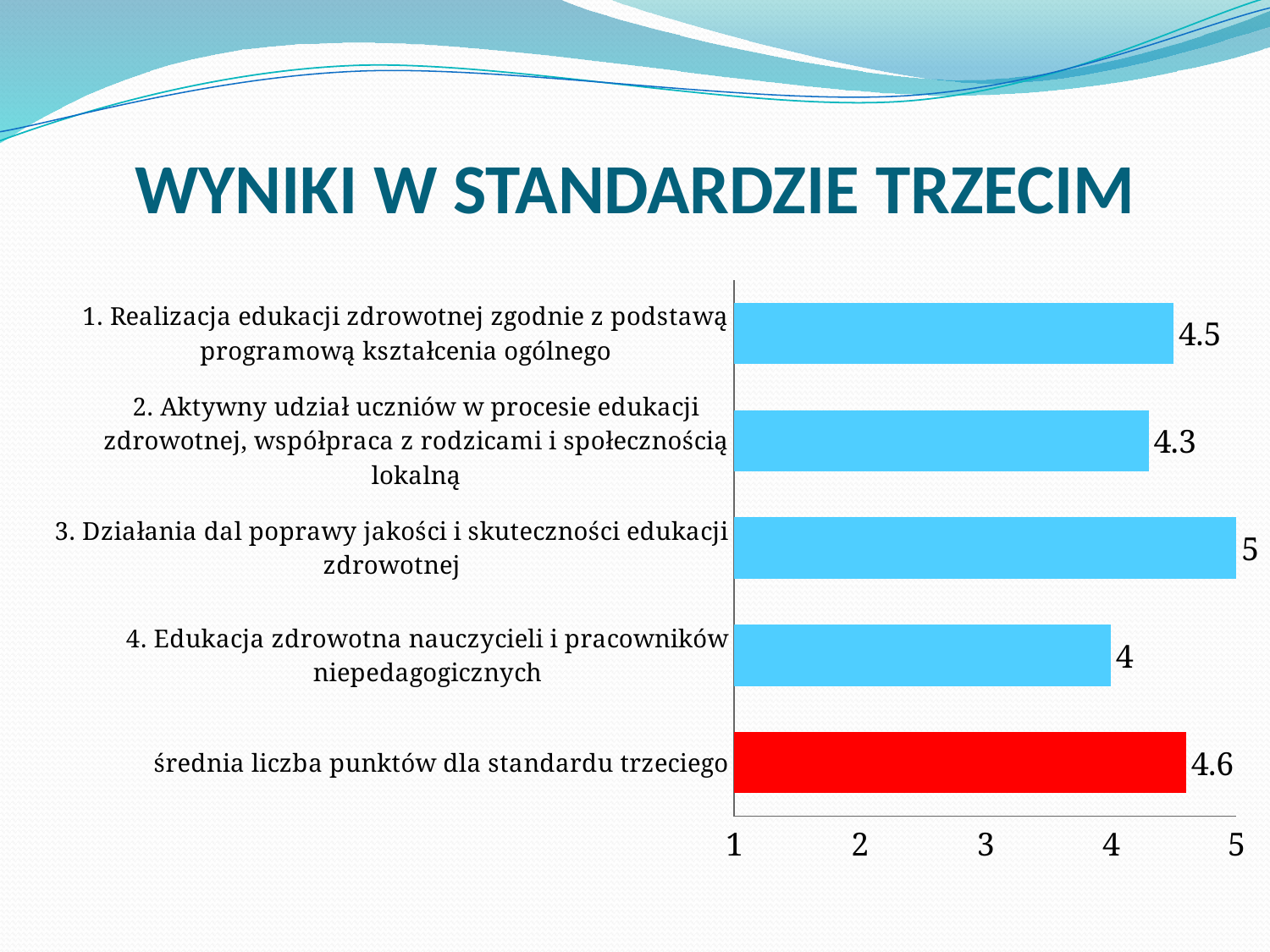
What value is shown for '1. Realizacja edukacji zdrowotnej zgodnie z podstawą programową kształcenia ogólnego'? 4.5 What colour is the bar for 'średnia liczba punktów dla standardu trzeciego'? Red What value is shown for '4. Edukacja zdrowotna nauczycieli i pracowników niepedagogicznych'? 4 What is the difference between the value for category 3 and the value for category 4? 1 What is the difference between the value for category 1 and the value for category 2? 0.2 What type of chart is shown on the slide? Bar chart Which category has the highest value? 3. Działania dal poprawy jakości i skuteczności edukacji zdrowotnej Which category has the lowest value? 4. Edukacja zdrowotna nauczycieli i pracowników niepedagogicznych Is the value for category 2 greater or less than 4? greater How many bars are shown in the chart? 5 Which is larger: the value for category 2 or the value for 'średnia liczba punktów dla standardu trzeciego'? średnia liczba punktów dla standardu trzeciego What is the value of the red bar, 'średnia liczba punktów dla standardu trzeciego'? 4.6